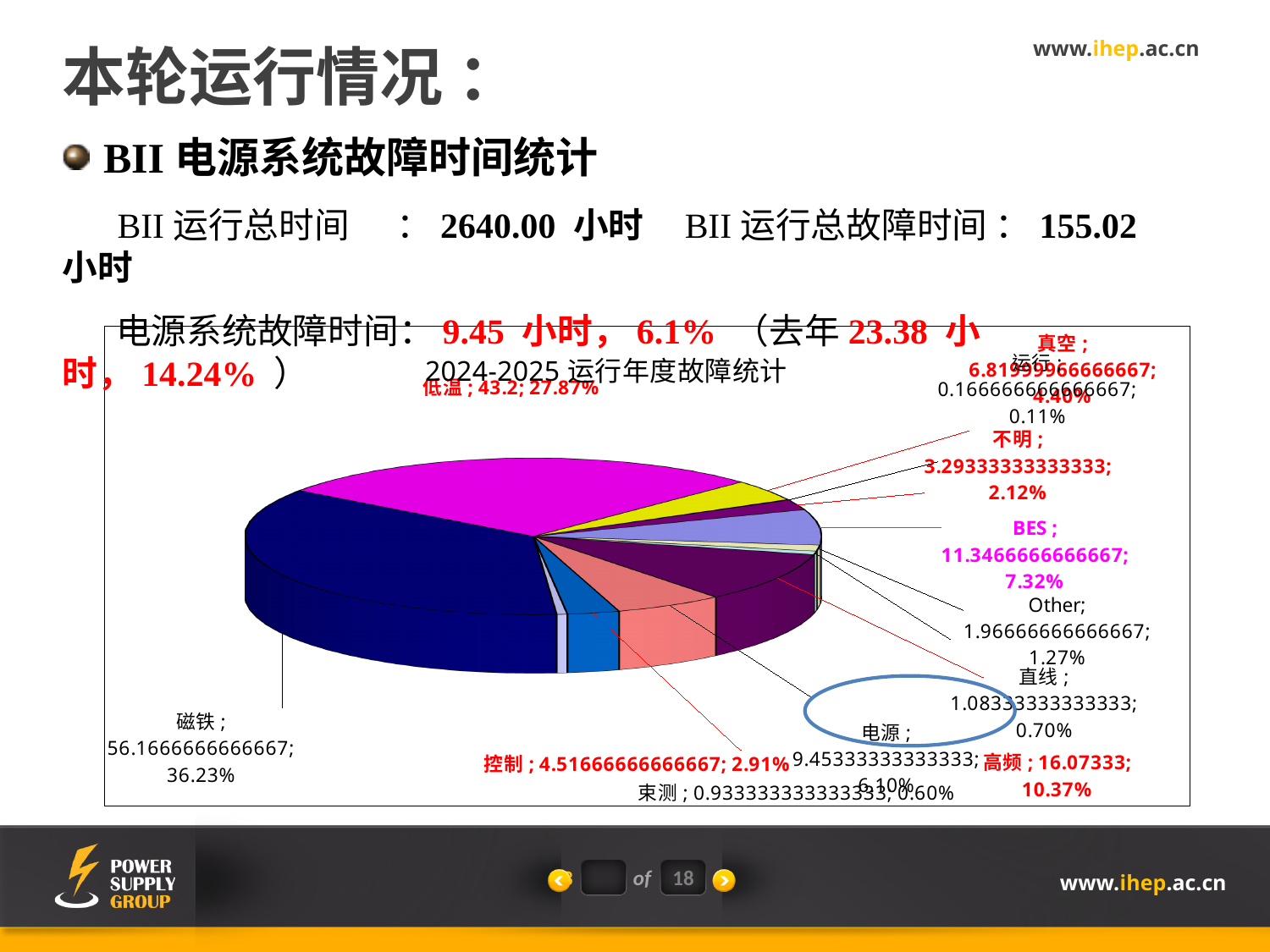
What is the title of the chart? 2024-2025 运行年度故障统计 What percentage share does the 磁铁 slice have? 36.23% Which slice is larger, 高频 or 电源? 高频 What value is shown for 低温? 43.2 How many categories are labelled in the pie chart? 12 What percentage share does the BES slice have? 7.32% Which category has the largest slice of the pie? 磁铁 What percentage share does the 电源 slice have? 6.10% Which category has the smallest slice of the pie? 运行 What kind of chart is shown on the slide? pie chart What is the difference in percentage share between 磁铁 and 低温? 8.36% What value is shown for 高频? 16.07333